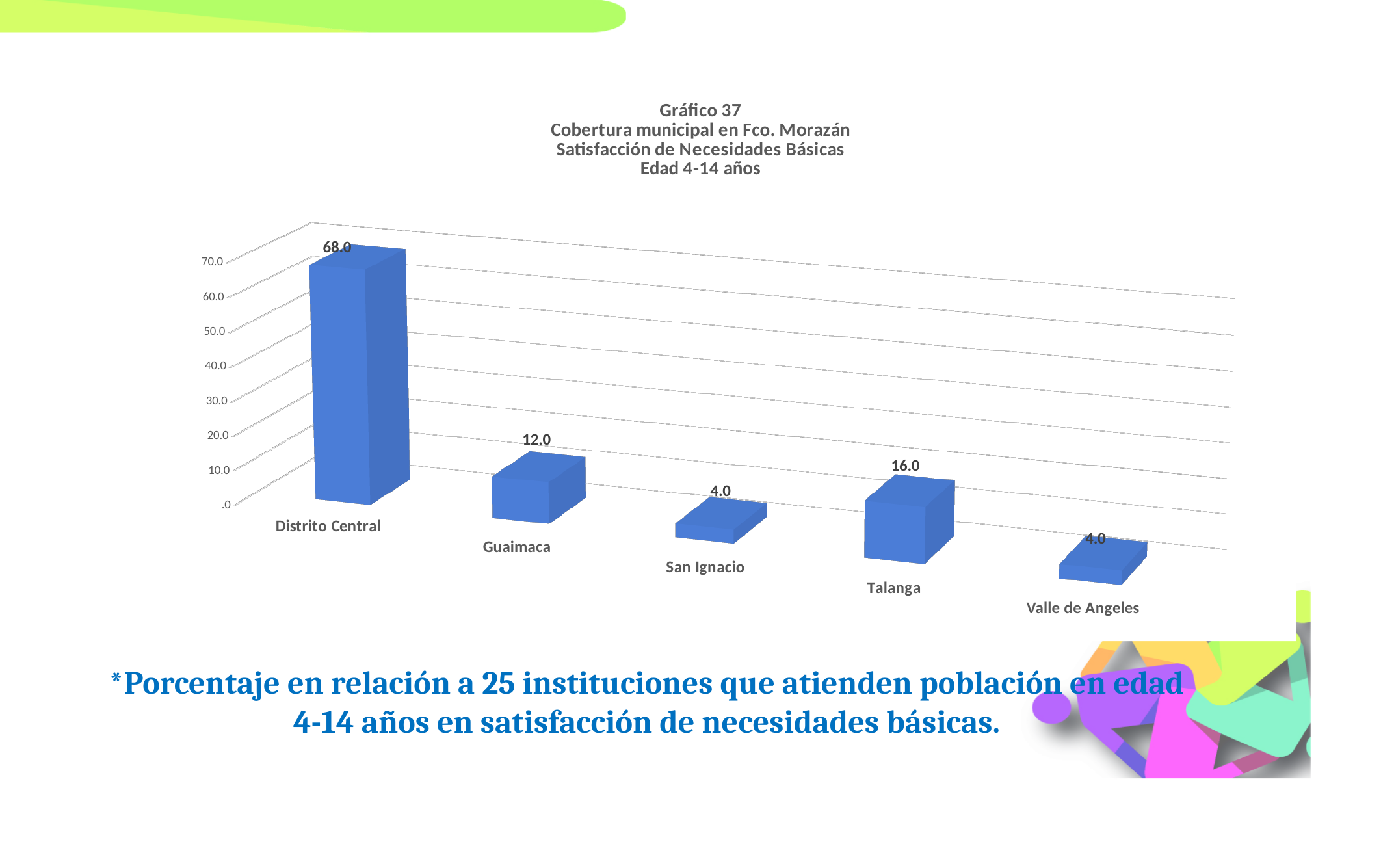
What is the value for Guaimaca? 12.0 Is the value for Distrito Central greater or less than 60.0? greater What is the number of the chart given in its title? Gráfico 37 What is the difference between the values for Distrito Central and Talanga? 52.0 Which is larger, the value for Guaimaca or the value for Talanga? Talanga What is the difference between the values for Talanga and Guaimaca? 4.0 What is the value for San Ignacio? 4.0 How many categories are shown on the x axis? 5 What is the value for Distrito Central? 68.0 What is the value for Talanga? 16.0 Which category has the highest value? Distrito Central What kind of chart is shown on the slide? Bar chart